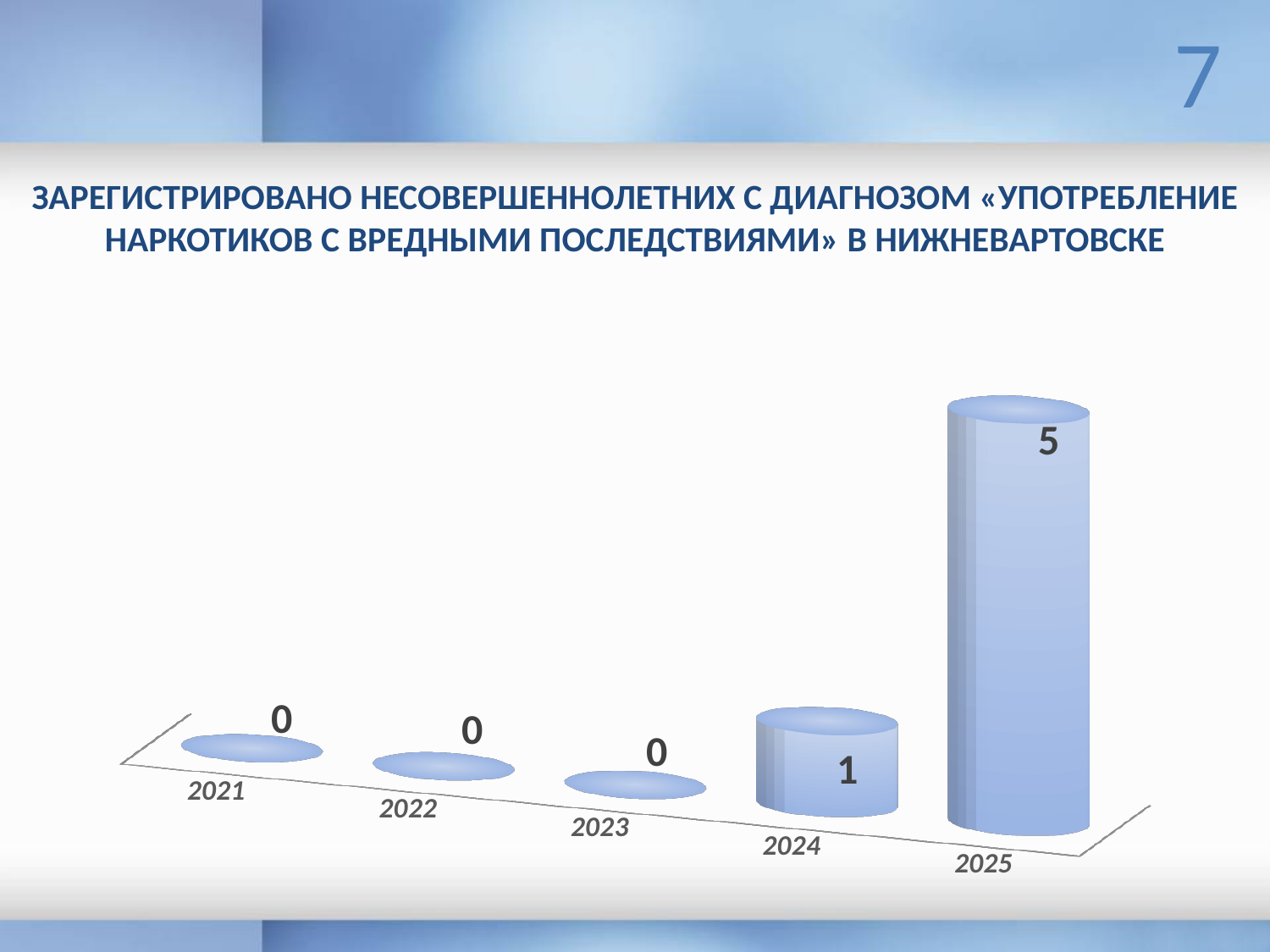
What kind of chart is shown on the slide? bar chart How many years have a value of 0? 3 What is the first year shown on the x axis? 2021 How many years are shown on the chart? 5 What is the value for 2023? 0 What is the value for 2021? 0 What is the value for 2024? 1 Which is larger, the value for 2024 or the value for 2022? 2024 Do the values rise or fall from 2023 to 2025? rise What is the value for 2025? 5 Which year has the highest value? 2025 What is the difference between the values for 2025 and 2024? 4